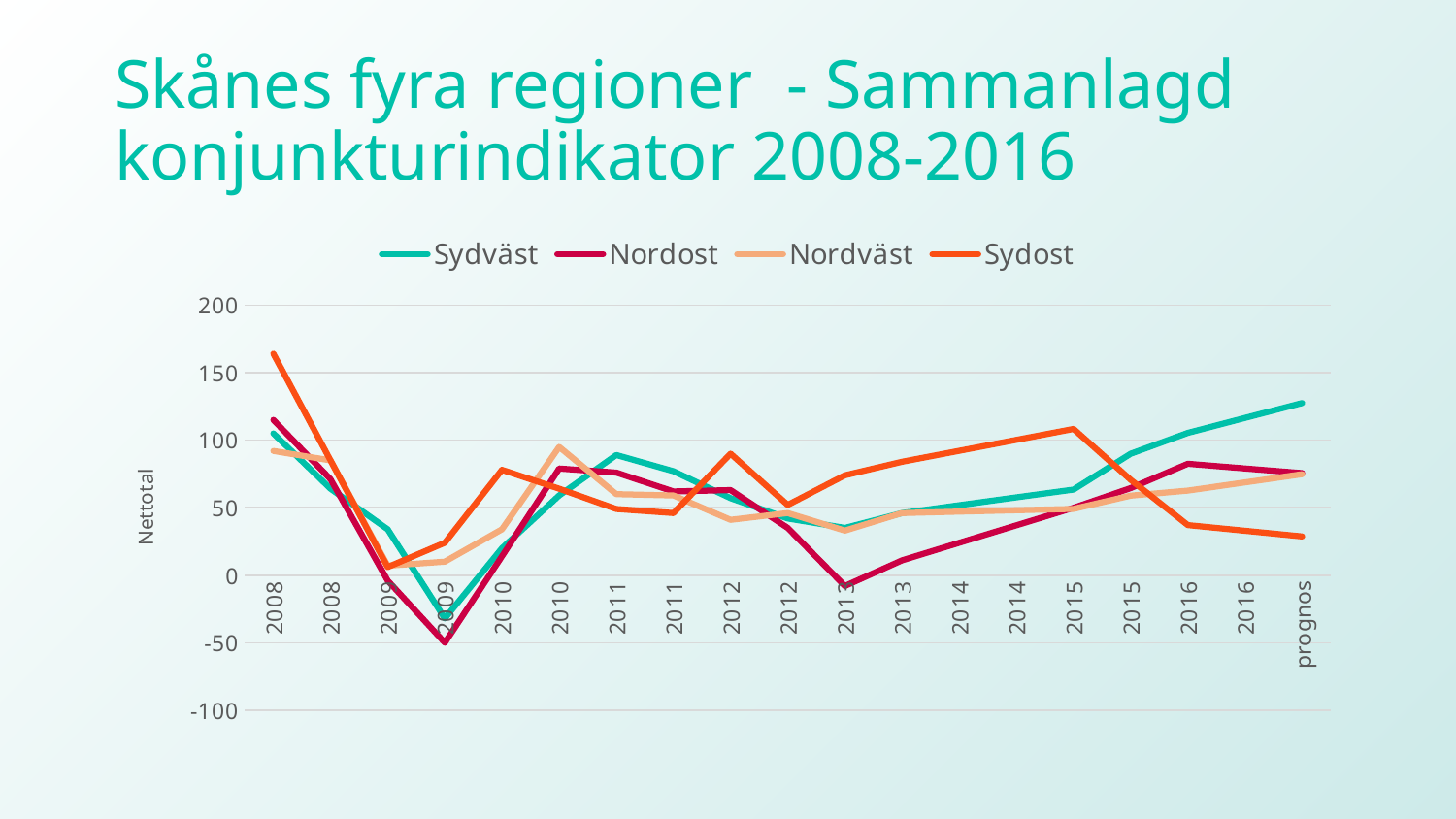
Which series has the highest value at the first 2008 point? Sydost Which series has the lowest value at the prognos point? Sydost Is the value for Sydväst at the prognos point greater or less than 100? greater Which series has the highest value at the prognos point? Sydväst How many points are there along the x axis? 19 What kind of chart is shown on the slide? line chart What is the label of the vertical axis? Nettotal At the first 2015 point, which is larger: Sydost or Sydväst? Sydost Is the value for Sydost at the prognos point greater or less than 50? less How many series does the legend list? 4 Is the value for Nordost at the second 2009 point greater or less than 0? less